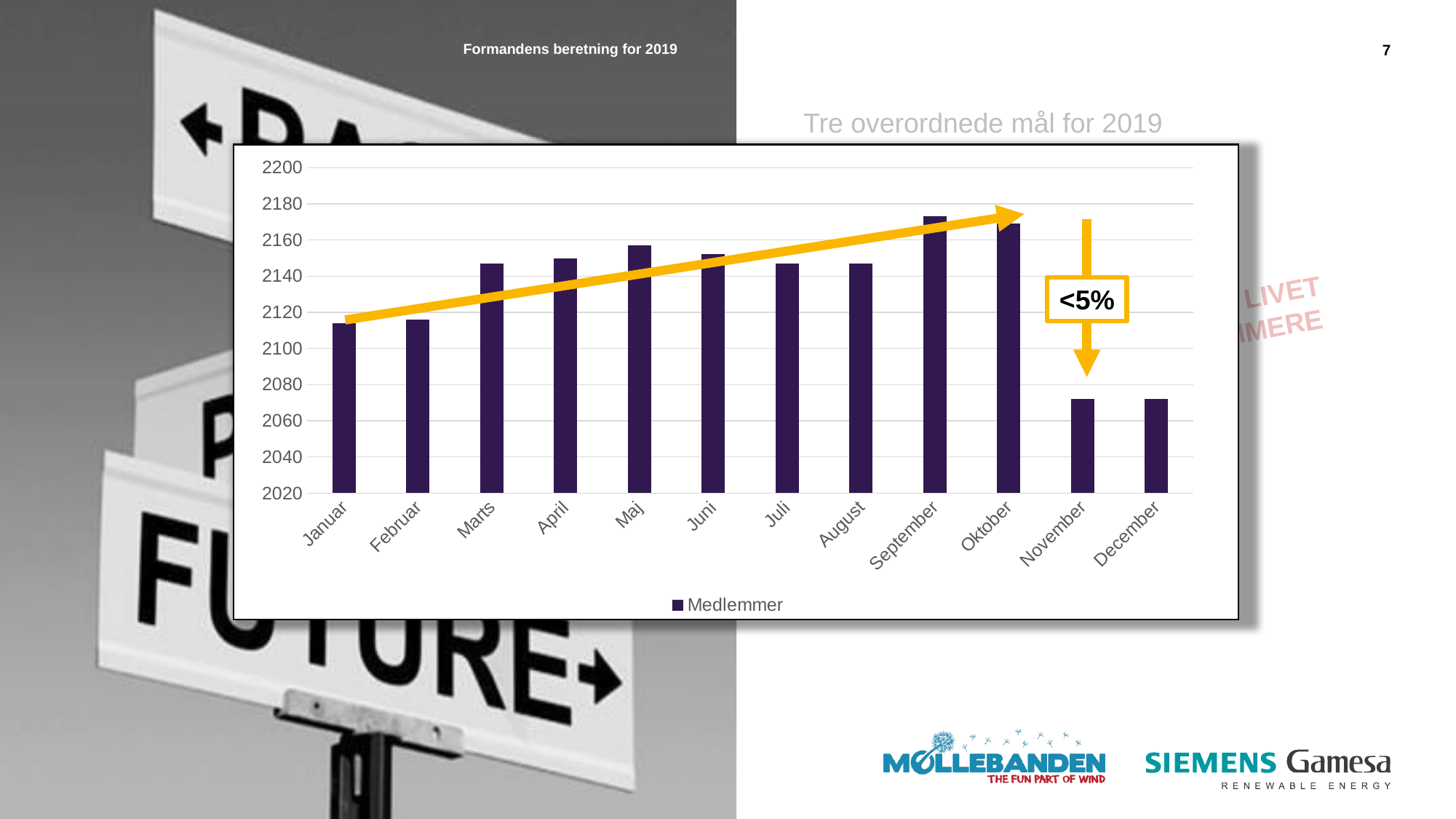
What is the name of the series shown in the chart's legend? Medlemmer How many months are shown on the x axis of the chart? 12 Which is larger, the value for September or the value for November? September Which is larger, the value for Januar or the value for Marts? Marts Is the value for November greater or less than 2080? less What text is shown in the box next to the downward arrow on the chart? <5% Is the value for September greater or less than 2160? greater Is the value for Maj greater or less than 2140? greater Do the values rise or fall from Oktober to November? fall What kind of chart is shown on the slide? bar chart How many series does the chart's legend list? 1